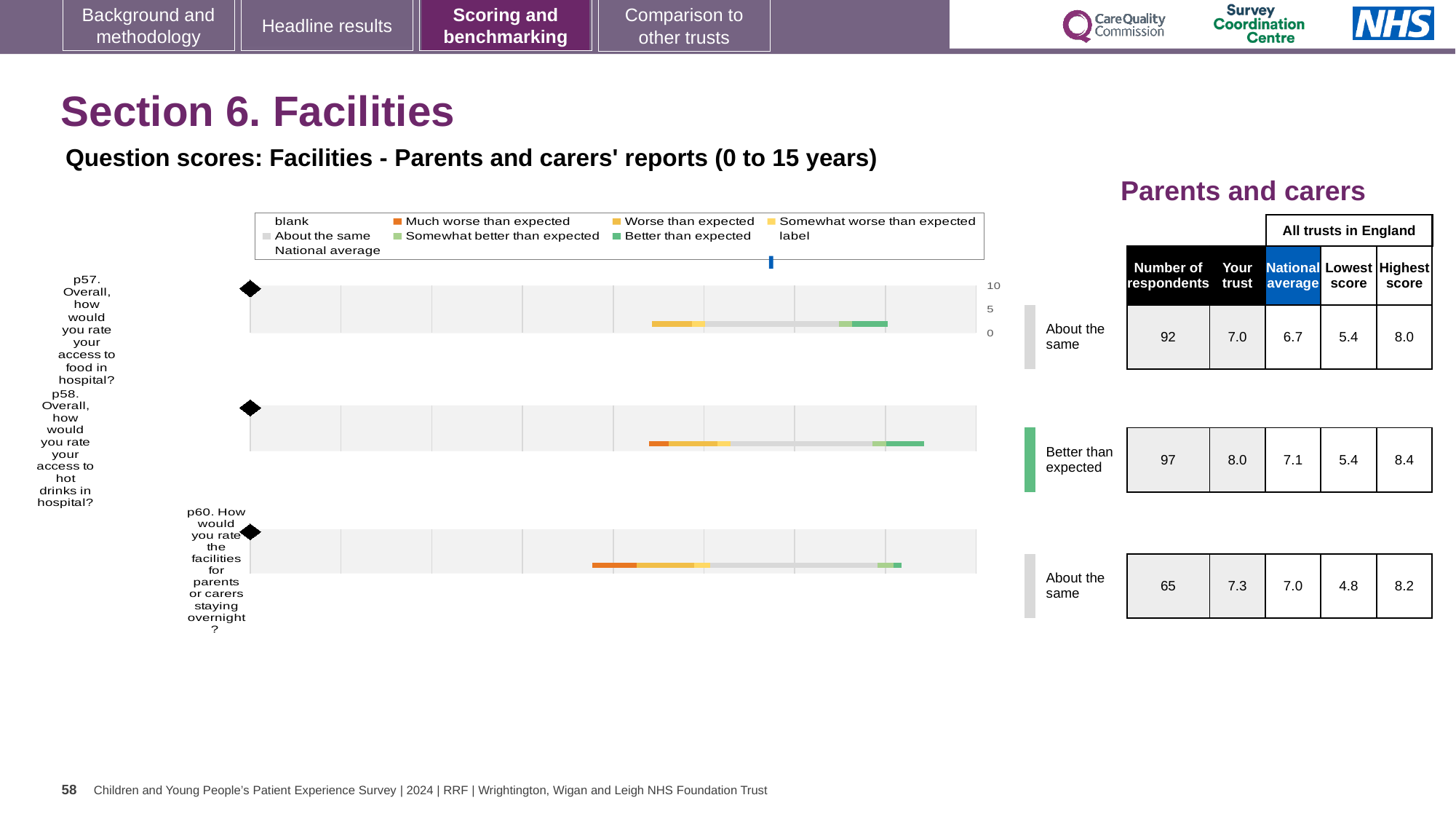
What kind of chart is used to show the question scores for Facilities? bar chart For p60, which is larger: the 'Your trust' score or the national average? Your trust What is the difference between the 'Your trust' score and the national average for p58? 0.9 What is the highest score across all trusts in England for p58? 8.4 Is the 'Your trust' score for p57 greater or less than 5? greater Which question has the highest 'Your trust' score? p58. Overall, how would you rate your access to hot drinks in hospital? Which question has the lowest number of respondents? p60. How would you rate the facilities for parents or carers staying overnight? How many questions (categories) are plotted in the Facilities chart? 3 What is the national average score for p58 (access to hot drinks in hospital)? 7.1 Which benchmark category is p58 (access to hot drinks) placed in? Better than expected What is the 'Your trust' score for p57 (access to food in hospital)? 7.0 How many respondents answered p60 (facilities for parents or carers staying overnight)? 65